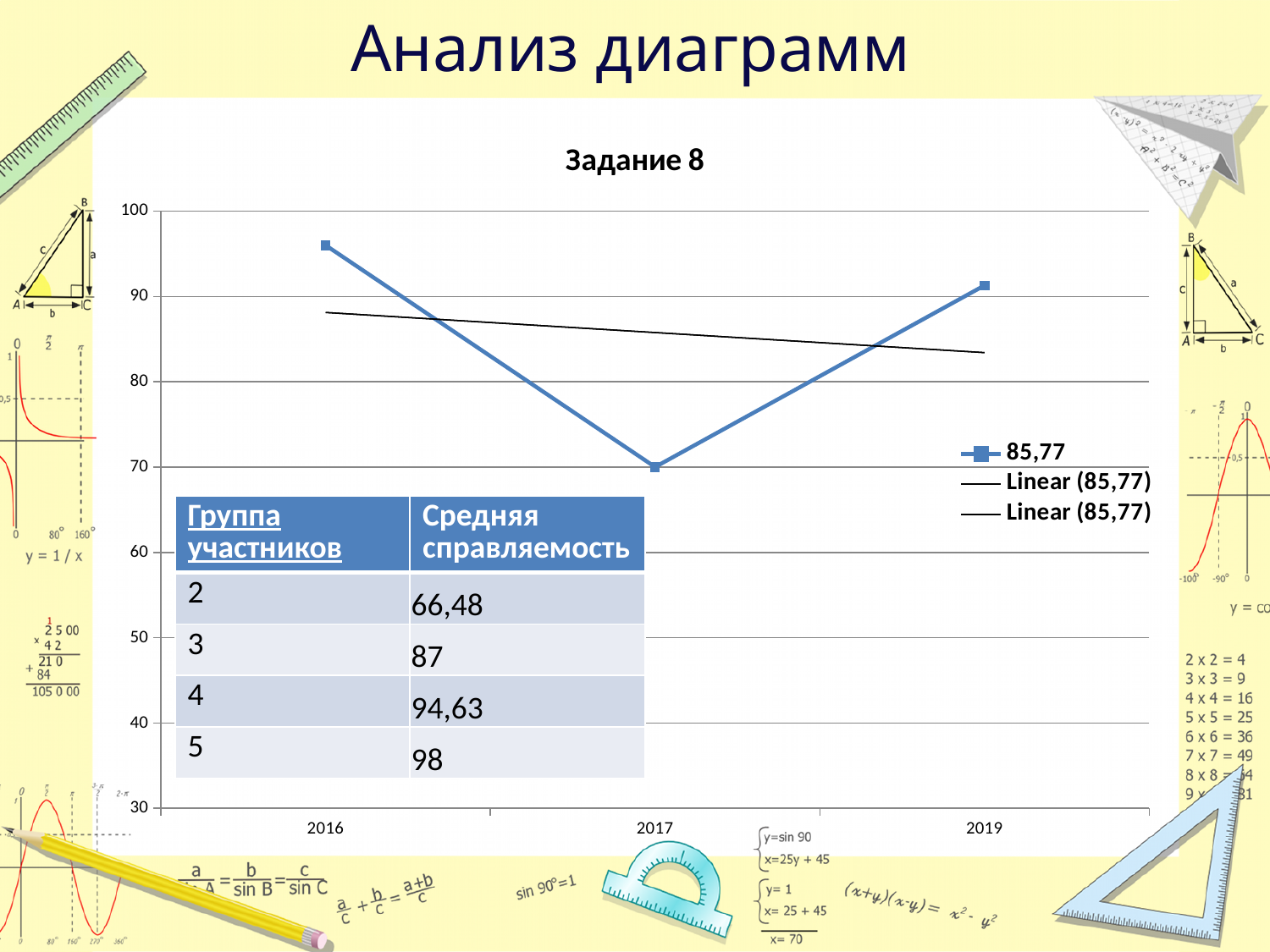
What is the title of the chart? Задание 8 Is the value for 2016 greater or less than 90? greater How many data points are plotted on the line in the chart? 3 How many entries does the chart legend list? 3 What kind of chart is shown on the slide? line chart Does the plotted line rise or fall from 2016 to 2017? fall Is the value for 2017 greater or less than 80? less Which is larger, the value for 2016 or the value for 2019? 2016 Does the linear trendline rise or fall from left to right? fall Which year has the highest value on the chart? 2016 Which year has the lowest value on the chart? 2017 Is the value for 2019 greater or less than 80? greater